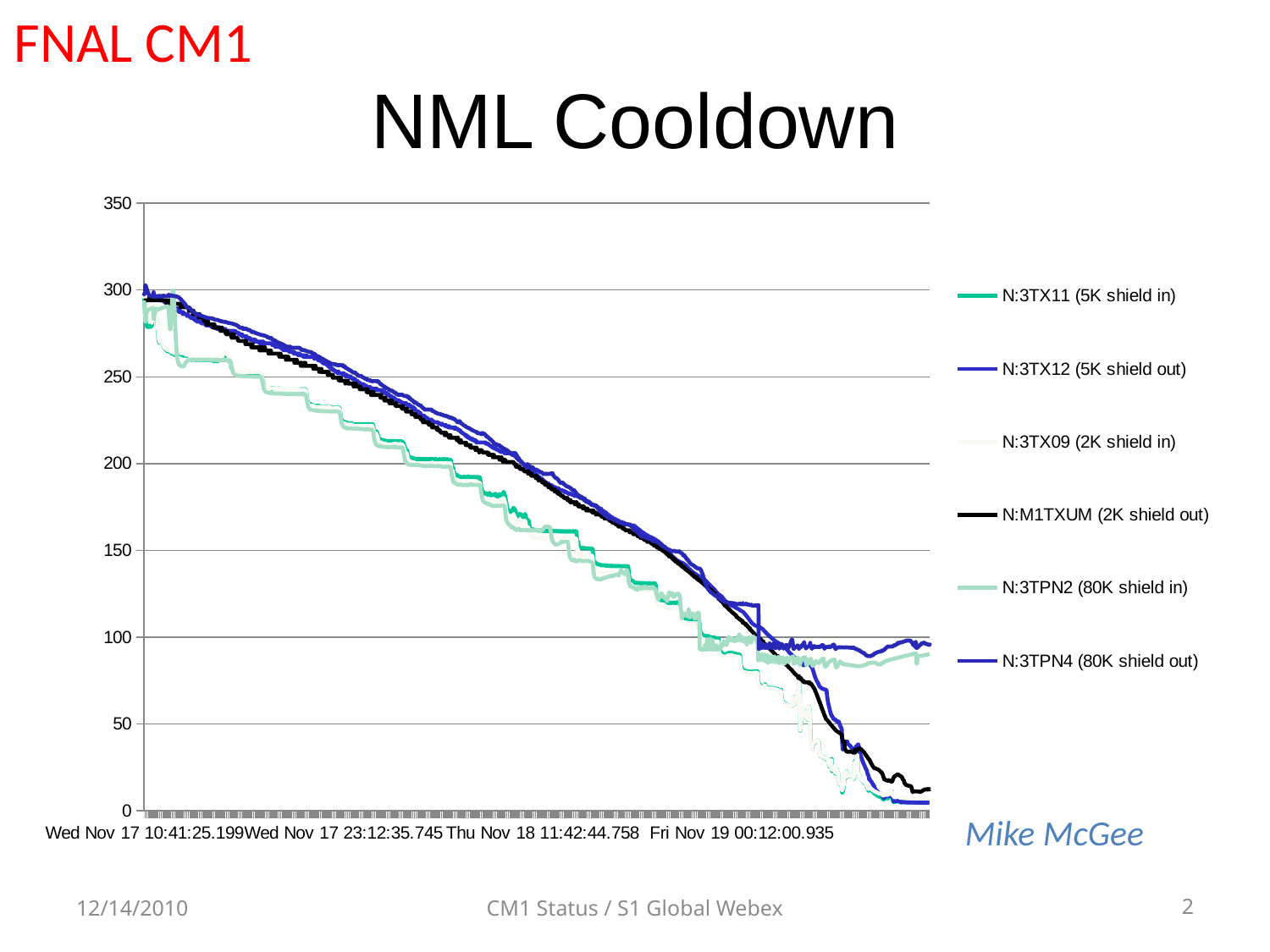
Do the values for N:M1TXUM (2K shield out) rise or fall over time along the x axis? fall Is the final value for N:3TPN2 (80K shield in) at the right end of the chart greater or less than 50? greater At the right end of the chart, which series ends higher: N:3TPN2 (80K shield in) or N:M1TXUM (2K shield out)? N:3TPN2 (80K shield in) Which legend entry is labelled as the 2K shield out sensor? N:M1TXUM (2K shield out) What kind of chart is shown on the slide? line chart Is the starting value for N:3TX12 (5K shield out) at the left end of the chart greater or less than 250? greater How many series does the legend list? 6 Is the final value for N:M1TXUM (2K shield out) at the right end of the chart greater or less than 50? less How many date labels are shown along the x axis? 4 What is the highest value shown on the y axis? 350 What is the title of the chart? NML Cooldown